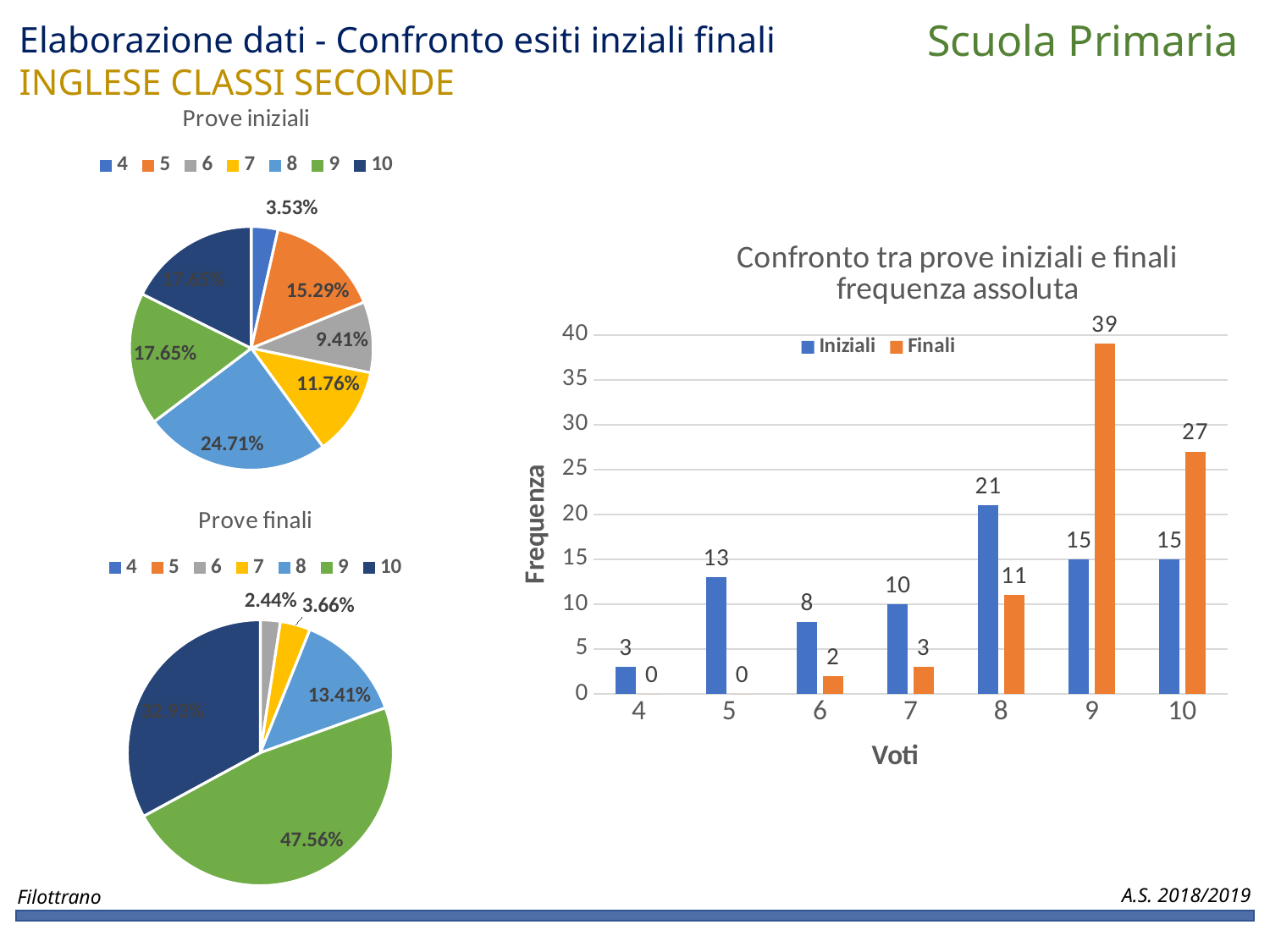
In the bar chart 'Confronto tra prove iniziali e finali frequenza assoluta', what is the difference between the Finali and Iniziali values for grade 10? 12 How many grade categories are shown on the x axis of the bar chart 'Confronto tra prove iniziali e finali frequenza assoluta'? 7 In the 'Prove iniziali' pie chart, what share does grade 8 have? 24.71% What kind of chart is 'Confronto tra prove iniziali e finali frequenza assoluta'? Bar chart In the bar chart 'Confronto tra prove iniziali e finali frequenza assoluta', what is the Finali value for grade 9? 39 In the 'Prove iniziali' pie chart, what is the percentage for grade 4? 3.53% In the bar chart 'Confronto tra prove iniziali e finali frequenza assoluta', which grade has the highest Iniziali value? 8 What is the label on the y axis of the bar chart 'Confronto tra prove iniziali e finali frequenza assoluta'? Frequenza In the bar chart 'Confronto tra prove iniziali e finali frequenza assoluta', which is larger for grade 5: Iniziali or Finali? Iniziali In the 'Prove finali' pie chart, what share does grade 9 have? 47.56% How many series does the legend of the bar chart 'Confronto tra prove iniziali e finali frequenza assoluta' list? 2 In the bar chart 'Confronto tra prove iniziali e finali frequenza assoluta', what is the Iniziali value for grade 8? 21